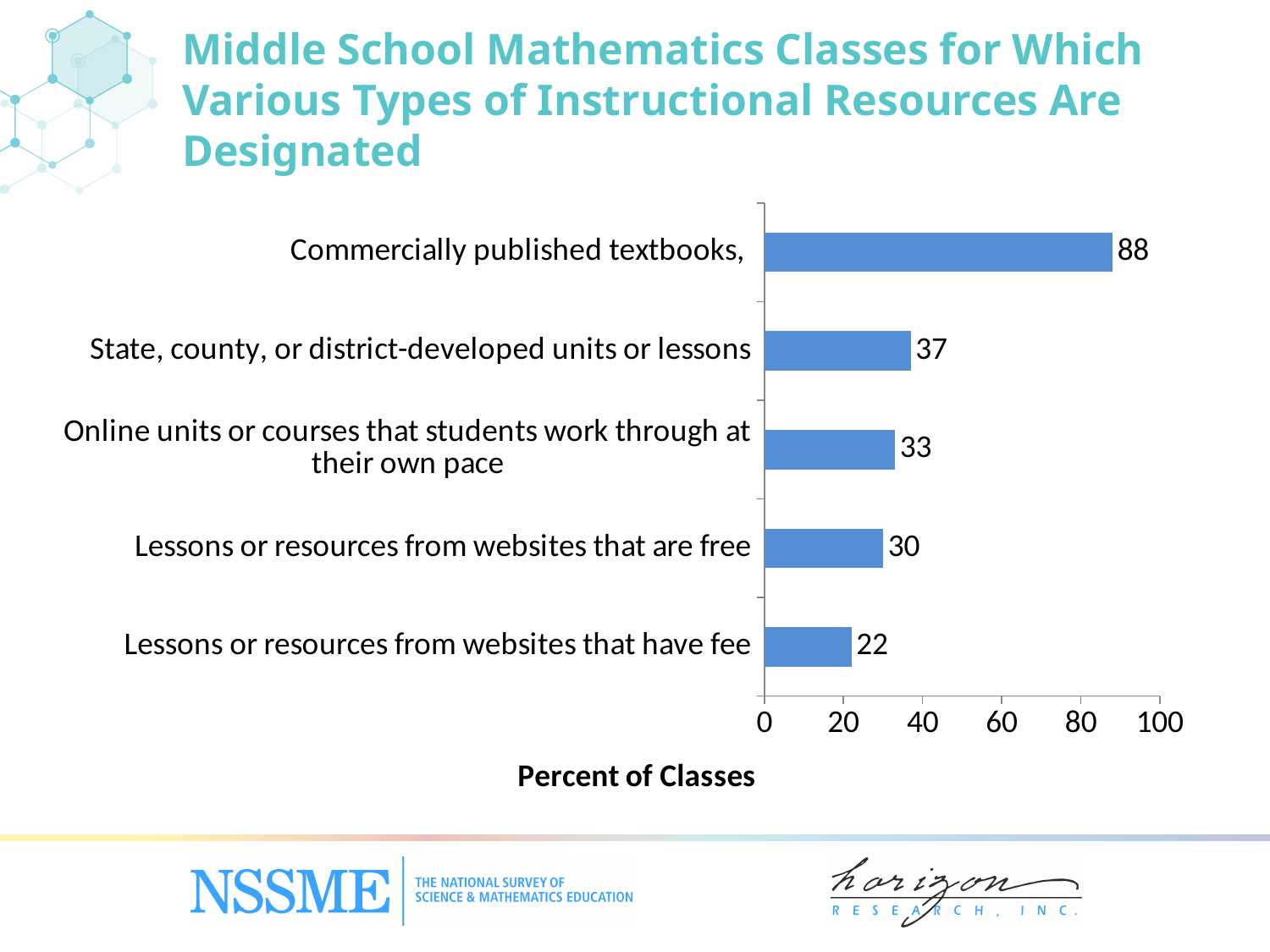
Which type of instructional resource has the lowest percent of classes? Lessons or resources from websites that have fee What kind of chart is shown on the slide? Bar chart How many types of instructional resources are shown in the chart? 5 What is the value for lessons or resources from websites that have fee? 22 What is the difference between the values for commercially published textbooks and state, county, or district-developed units or lessons? 51 What is the value for online units or courses that students work through at their own pace? 33 Which is larger: the value for state, county, or district-developed units or lessons, or the value for lessons or resources from websites that are free? State, county, or district-developed units or lessons What is the difference between the values for lessons or resources from websites that are free and those that have fee? 8 Is the value for commercially published textbooks greater or less than 80? greater What percent of classes designate commercially published textbooks? 88 What is the label of the horizontal axis? Percent of Classes Which type of instructional resource has the highest percent of classes? Commercially published textbooks